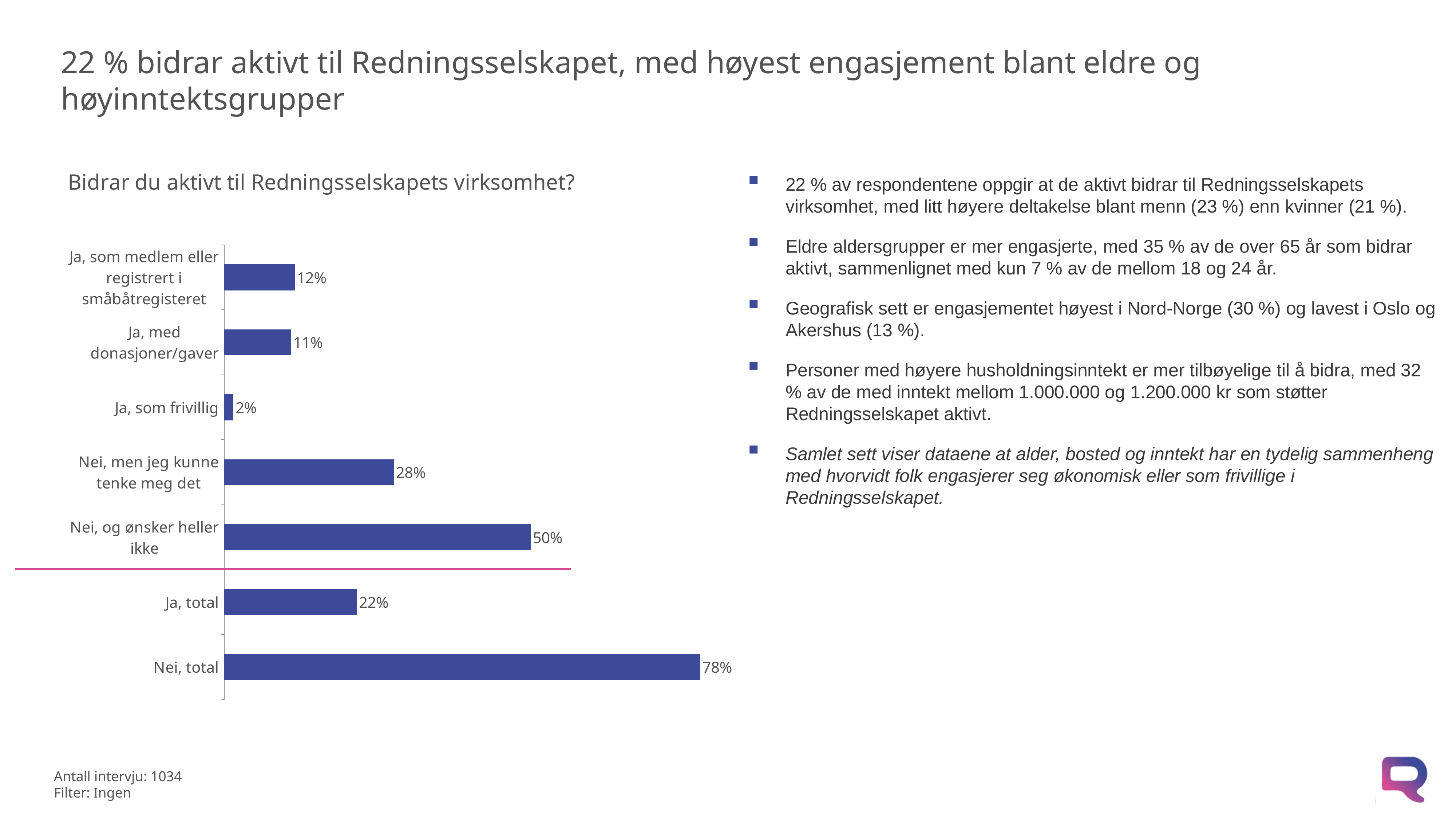
Which category has the lowest value? Ja, som frivillig What is the value for "Ja, med donasjoner/gaver"? 11% Which category has the highest value? Nei, total What kind of chart is shown on the slide? Bar chart How many categories are shown in the chart? 7 What is the value for "Nei, og ønsker heller ikke"? 50% Which is larger: "Ja, som medlem eller registrert i småbåtregisteret" or "Ja, med donasjoner/gaver"? Ja, som medlem eller registrert i småbåtregisteret What is the value for "Ja, som frivillig"? 2% What is the value for "Ja, total"? 22% What is the title of the chart? Bidrar du aktivt til Redningsselskapets virksomhet? What is the value for "Nei, men jeg kunne tenke meg det"? 28% What is the difference between "Nei, total" and "Ja, total"? 56%